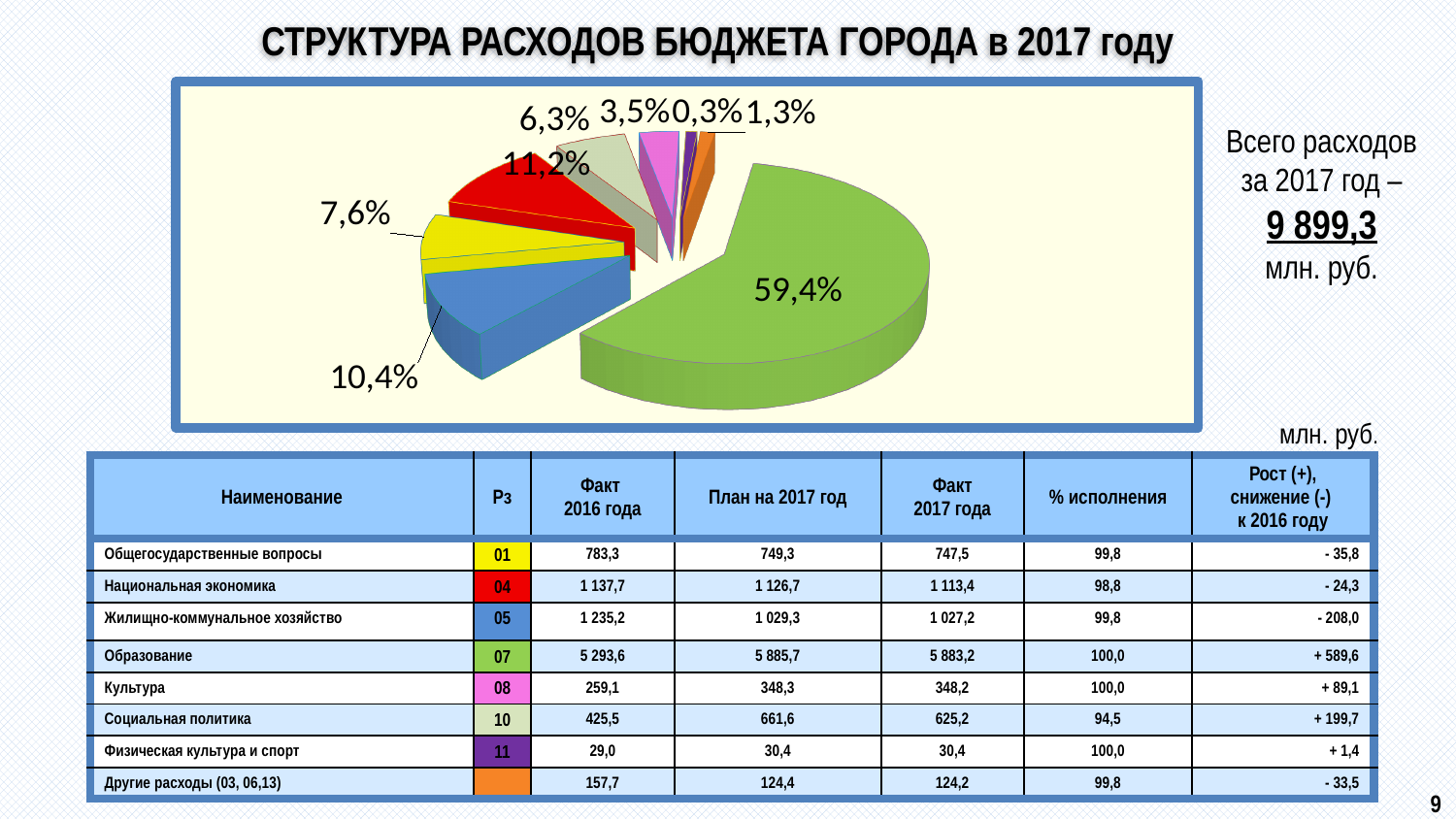
By how many percentage points does the red slice (11,2%) exceed the blue slice (10,4%)? 0,8 What total expenditure for 2017 is stated next to the pie chart? 9 899,3 млн. руб. What is the value of the smallest slice of the pie chart? 0,3% What share does the red slice (Национальная экономика, code 04) have in the pie chart? 11,2% Which slice is larger in the pie chart, the red one (11,2%) or the blue one (10,4%)? the red one (11,2%) What share does the yellow slice (Общегосударственные вопросы, code 01) have in the pie chart? 7,6% What kind of chart is shown on the slide? pie chart What is the title of the slide containing the pie chart? СТРУКТУРА РАСХОДОВ БЮДЖЕТА ГОРОДА в 2017 году What share does the green slice (Образование, code 07) have in the pie chart? 59,4% What share does the blue slice (Жилищно-коммунальное хозяйство, code 05) have in the pie chart? 10,4% What is the value of the largest slice of the pie chart? 59,4% How many slices does the pie chart have? 8